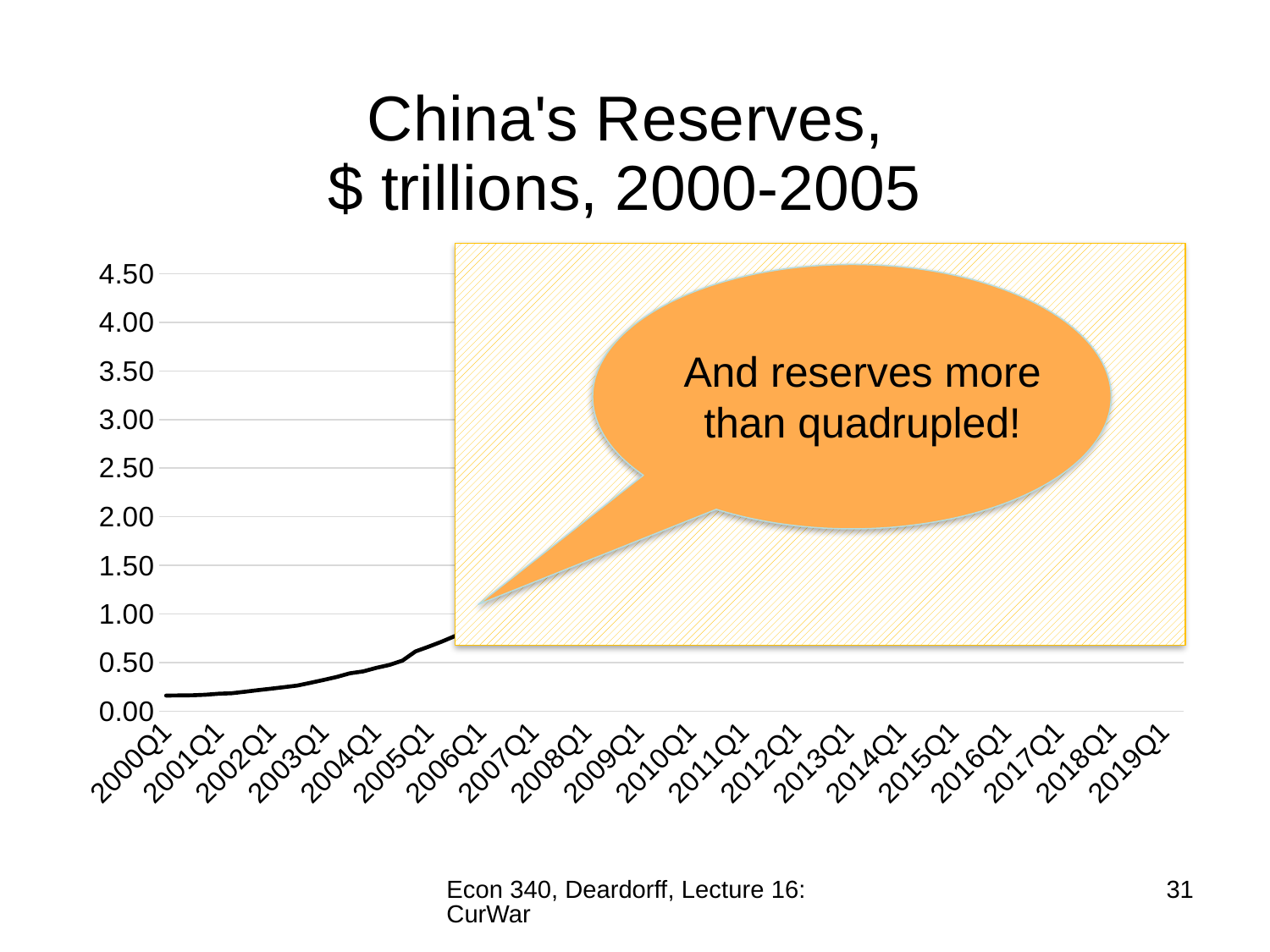
Is the value for 2005Q1 greater or less than 1.00? less Is the value for 2003Q1 greater or less than 0.50? less What kind of chart is shown on the slide? line chart Do China's reserves rise or fall between 2000Q1 and 2005Q1? rise What is the highest value labelled on the vertical axis? 4.50 Which is larger, the value for 2005Q1 or the value for 2000Q1? 2005Q1 Which is larger, the value for 2001Q1 or the value for 2004Q1? 2004Q1 Is the value for 2000Q1 greater or less than 1.00? less What is the title of the chart? China's Reserves, $ trillions, 2000-2005 How many quarter labels are shown on the x axis? 20 What is the first quarter label on the x axis? 2000Q1